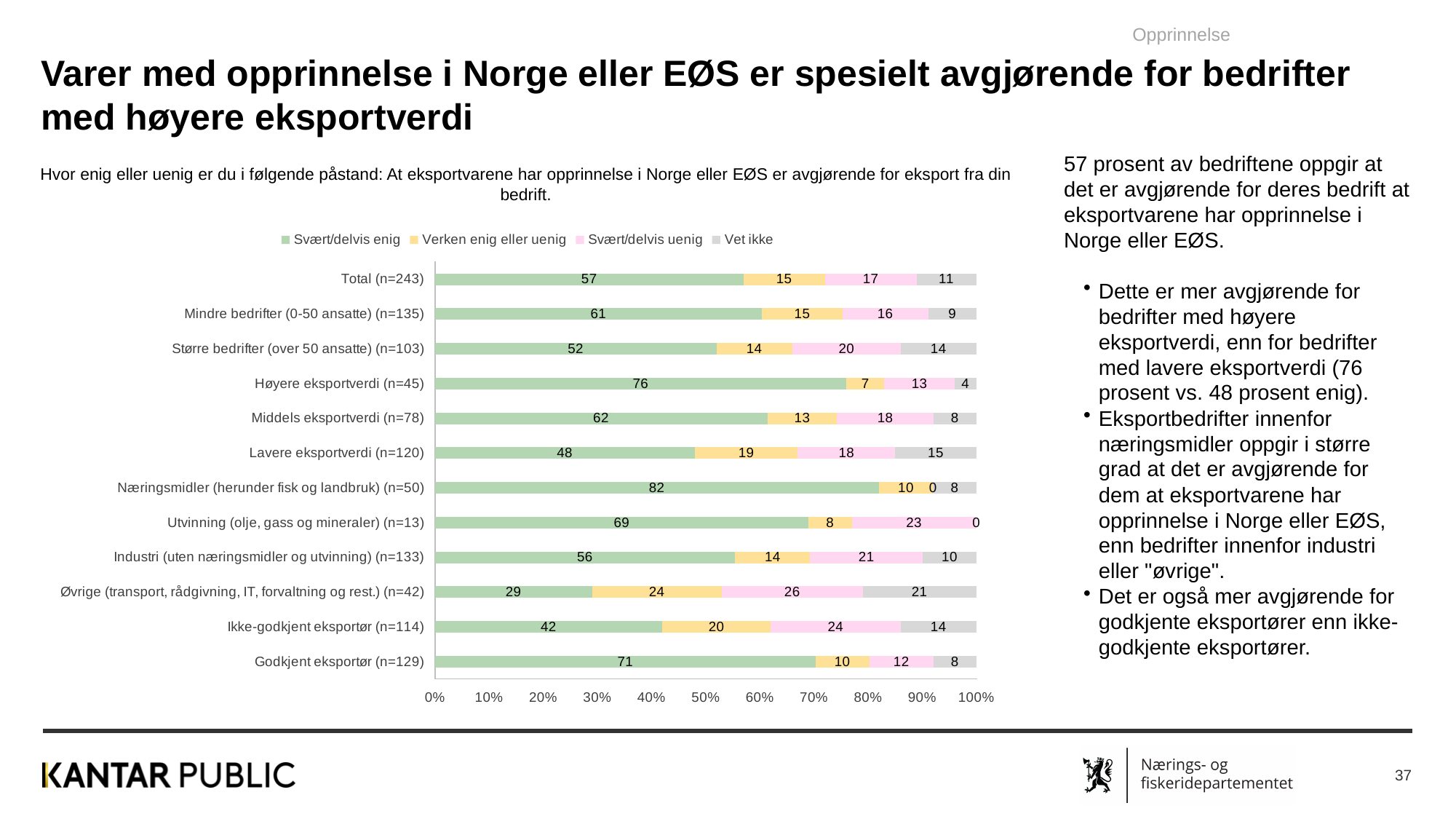
What is the difference in "Svært/delvis enig" between Høyere eksportverdi (n=45) and Lavere eksportverdi (n=120)? 28 Which category has the lowest value for "Svært/delvis enig"? Øvrige (transport, rådgivning, IT, forvaltning og rest.) (n=42) How many categories are shown on the chart? 12 What kind of chart is shown on the slide? Stacked bar chart What is the value of "Vet ikke" for Større bedrifter (over 50 ansatte) (n=103)? 14 What is the total of the stacked bar for Total (n=243)? 100 Which has a larger "Svært/delvis enig" value: Godkjent eksportør (n=129) or Ikke-godkjent eksportør (n=114)? Godkjent eksportør (n=129) What is the value of "Svært/delvis enig" for Total (n=243)? 57 What is the value of "Svært/delvis uenig" for Utvinning (olje, gass og mineraler) (n=13)? 23 Which category has the highest value for "Svært/delvis enig"? Næringsmidler (herunder fisk og landbruk) (n=50) How many series does the legend list? 4 Which legend entry is shown in green? Svært/delvis enig